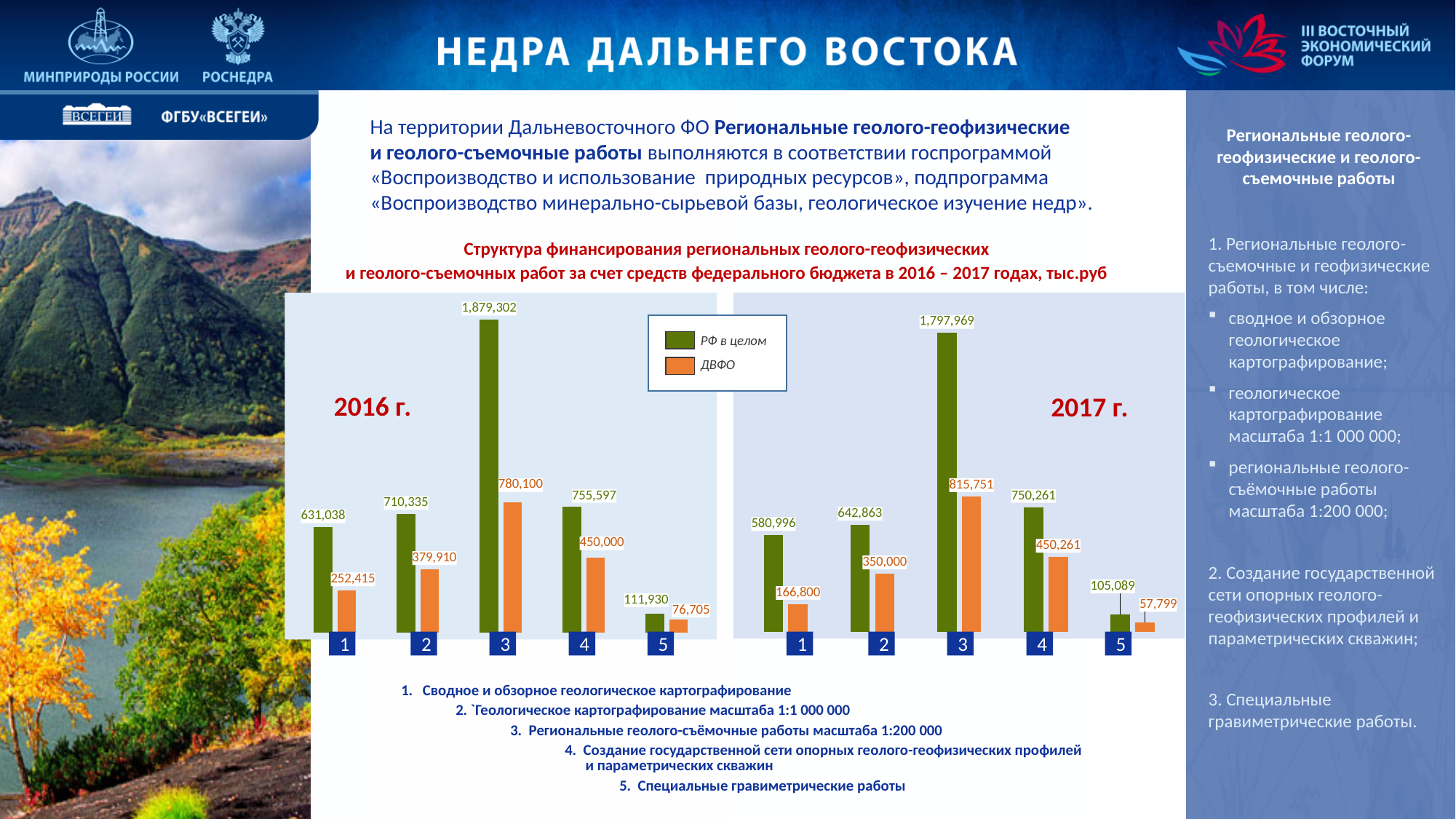
In the 2016 chart, what is the value for РФ в целом for category 3? 1,879,302 How many categories are shown in the 2017 chart? 5 In the 2016 chart, what is the value for ДВФО for category 1? 252,415 In the 2016 chart, which category has the highest value for РФ в целом? 3 What type of chart is the 2016 chart? bar chart In the 2016 chart, what is the difference between the РФ в целом and ДВФО values for category 4? 305,597 In the 2017 chart, which is larger for category 2: РФ в целом or ДВФО? РФ в целом In the 2017 chart, what is the difference between the ДВФО values for category 3 and category 2? 465,751 In the 2017 chart, what is the value for ДВФО for category 4? 450,261 In the 2017 chart, what is the value for РФ в целом for category 5? 105,089 In the 2017 chart, which category has the lowest value for ДВФО? 5 How many series does the legend list? 2